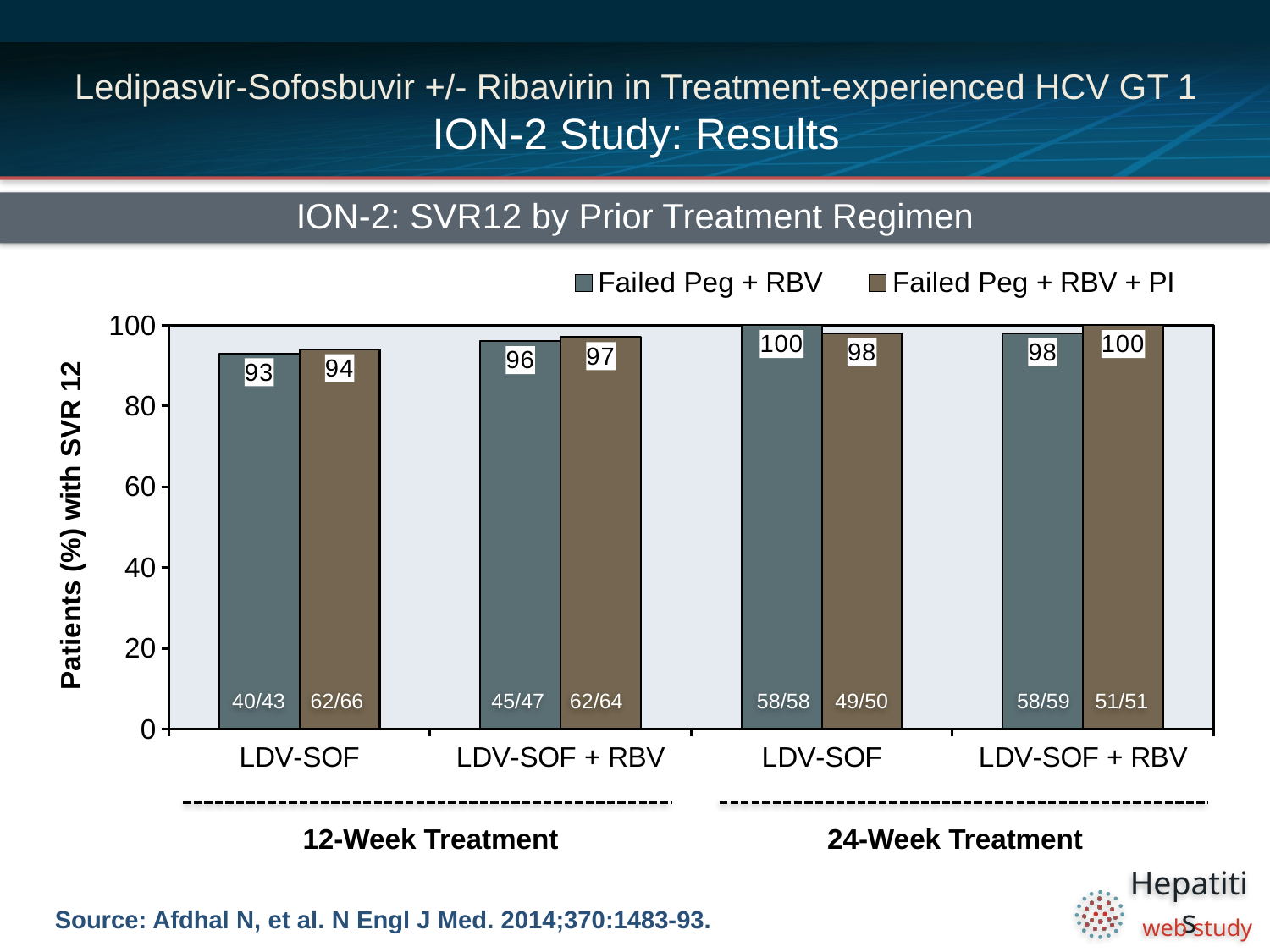
How many treatment arms (category groups) are shown on the x axis? 4 What is the SVR12 rate for the Failed Peg + RBV group receiving 12-week LDV-SOF? 93 Is the SVR12 rate for the Failed Peg + RBV group receiving 12-week LDV-SOF + RBV greater or less than 80? greater What is the SVR12 rate for the Failed Peg + RBV + PI group receiving 24-week LDV-SOF? 98 What is the title of the chart? ION-2: SVR12 by Prior Treatment Regimen Which treatment arm has the lowest SVR12 rate for the Failed Peg + RBV group? 12-Week LDV-SOF What kind of chart is shown on the slide? Bar chart For 24-week LDV-SOF, which group has the higher SVR12 rate: Failed Peg + RBV or Failed Peg + RBV + PI? Failed Peg + RBV What is the SVR12 rate for the Failed Peg + RBV + PI group receiving 12-week LDV-SOF + RBV? 97 What fraction of patients is shown for the Failed Peg + RBV group receiving 24-week LDV-SOF + RBV? 58/59 How many series does the legend list? 2 What is the difference in SVR12 rate between the Failed Peg + RBV + PI group and the Failed Peg + RBV group for 12-week LDV-SOF? 1